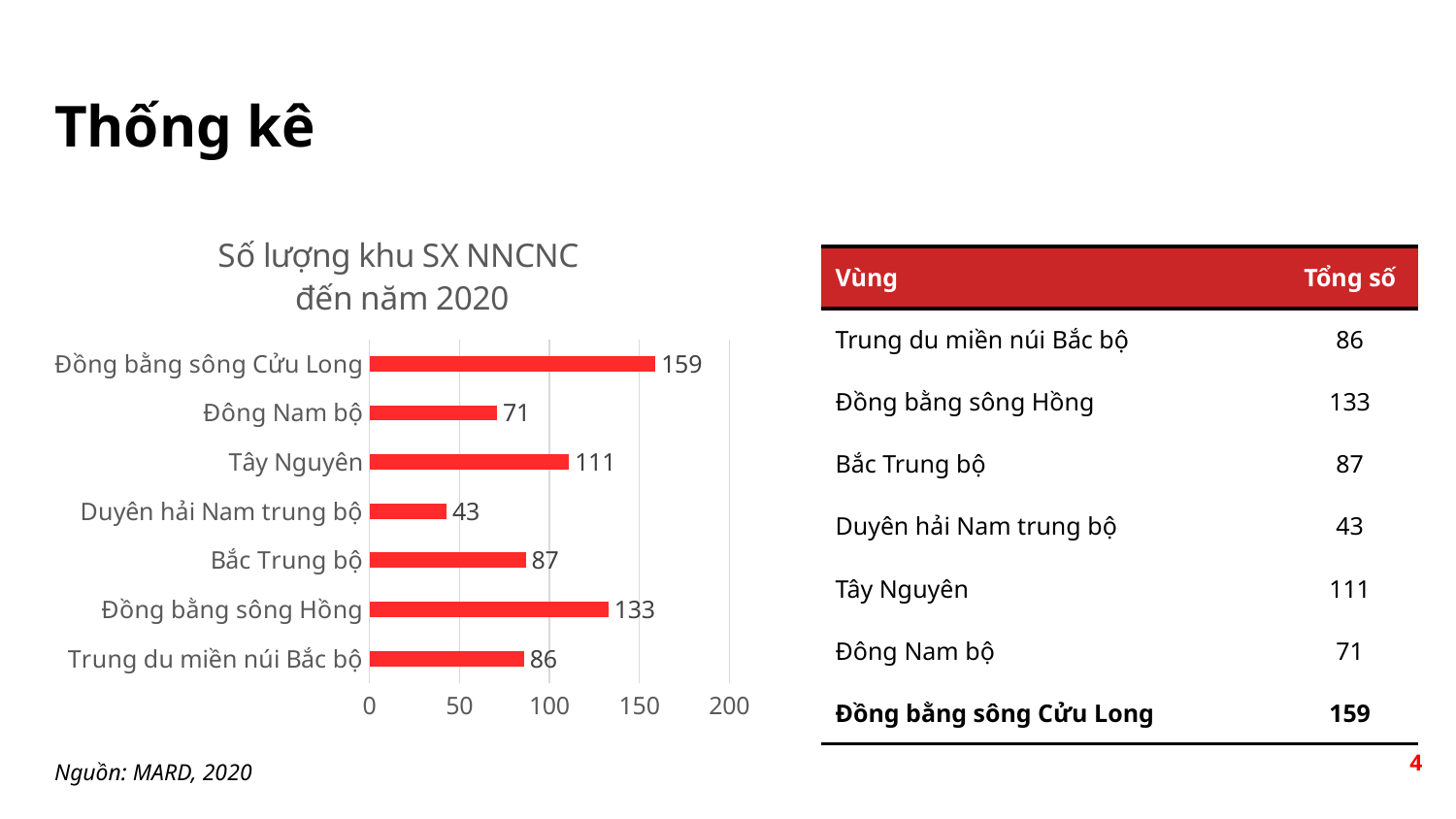
What is the value for Duyên hải Nam trung bộ in the chart? 43 How many regions are shown in the chart? 7 What is the value for Tây Nguyên in the chart? 111 Which is larger, the value for Bắc Trung bộ or the value for Đông Nam bộ? Bắc Trung bộ What is the difference between the values for Tây Nguyên and Đông Nam bộ? 40 What kind of chart is shown on the slide? bar chart What is the value for Đồng bằng sông Cửu Long in the chart? 159 What is the title of the chart? Số lượng khu SX NNCNC đến năm 2020 What is the difference between the values for Đồng bằng sông Cửu Long and Đồng bằng sông Hồng? 26 Is the value for Đồng bằng sông Hồng greater or less than 100? greater Which region has the highest value in the chart? Đồng bằng sông Cửu Long Which region has the lowest value in the chart? Duyên hải Nam trung bộ